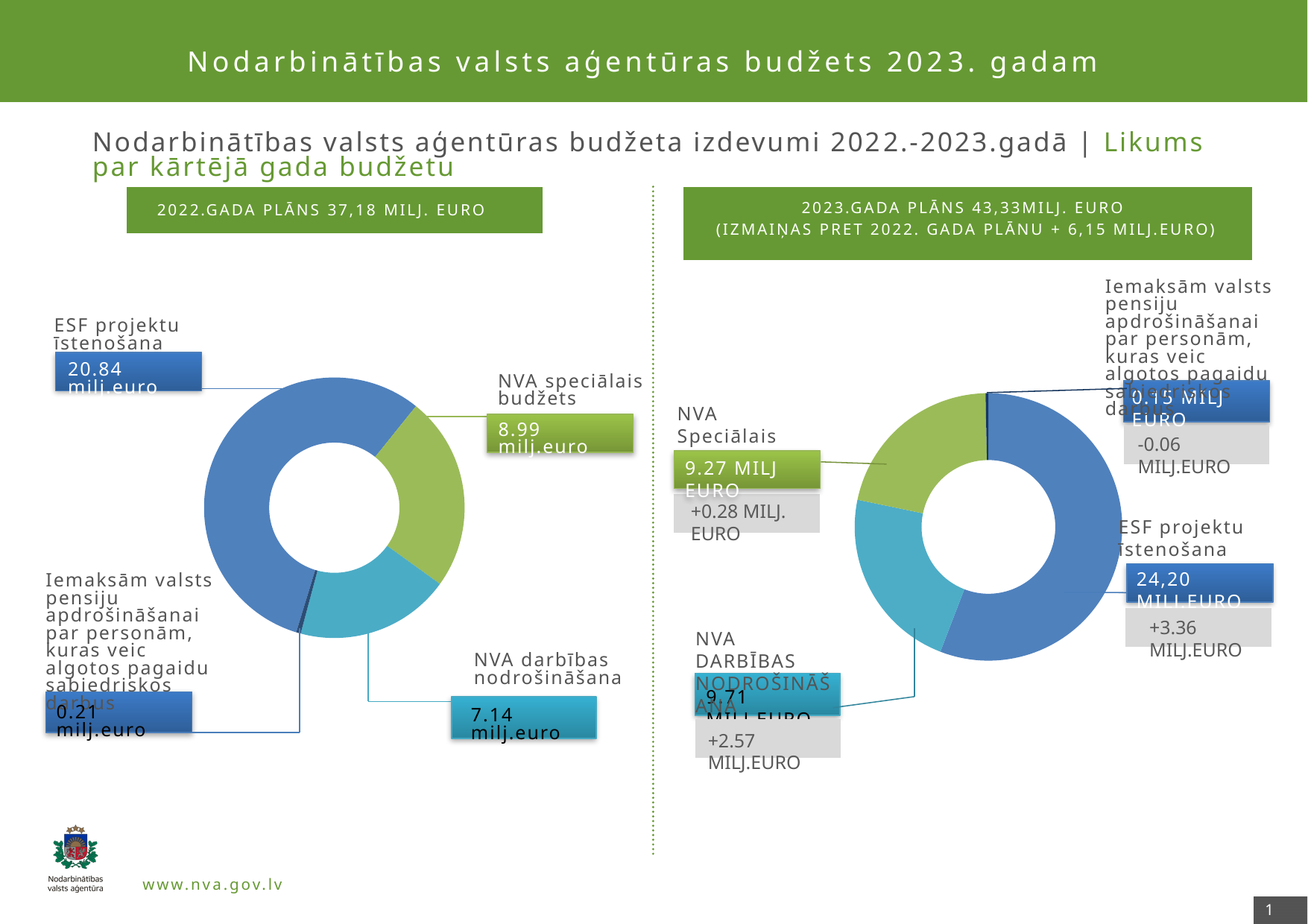
On the left chart (2022.gada plāns), what is the value for ESF projektu īstenošana? 20.84 milj.euro What total is stated in the header above the right chart for the 2023 plan? 43,33 milj. euro On the left chart (2022.gada plāns), which category has the largest share? ESF projektu īstenošana On the left chart (2022.gada plāns), what is the difference between NVA speciālais budžets and NVA darbības nodrošināšana? 1.85 milj.euro On the left chart (2022.gada plāns), which category has the smallest share? Iemaksām valsts pensiju apdrošināšanai par personām, kuras veic algotos pagaidu sabiedriskos darbus What type of chart is used on the left side of the slide? Doughnut chart On the right chart (2023.gada plāns), what is the value for ESF projektu īstenošana? 24,20 MILJ.EURO On the right chart (2023.gada plāns), what is the change versus the 2022 plan for NVA darbības nodrošināšana? +2.57 MILJ.EURO How many categories does the left chart (2022.gada plāns) show? 4 On the right chart (2023.gada plāns), what is the value for NVA Speciālais? 9.27 MILJ EURO On the left chart (2022.gada plāns), what is the value for NVA darbības nodrošināšana? 7.14 milj.euro On the right chart (2023.gada plāns), which is larger: NVA Speciālais or NVA darbības nodrošināšana? NVA darbības nodrošināšana